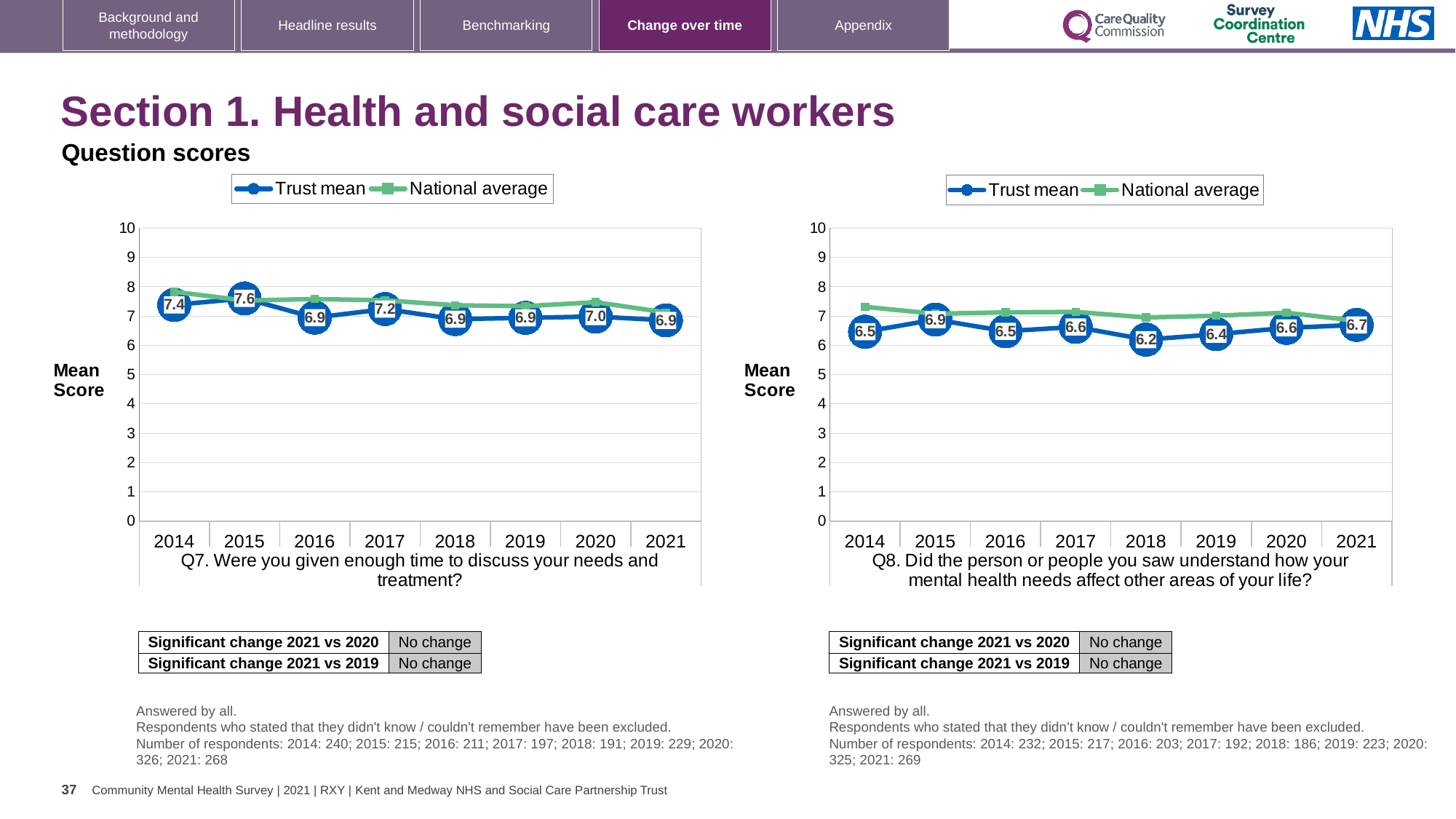
In the Q7 chart, which year has the highest Trust mean? 2015 In the Q7 chart, what is the Trust mean for 2021? 6.9 In the Q8 chart, what is the Trust mean for 2018? 6.2 In the Q7 chart, what is the Trust mean for 2015? 7.6 In the Q8 chart, which year has the lowest Trust mean? 2018 In the Q7 chart, what is the difference between the Trust mean in 2015 and in 2016? 0.7 How many years are plotted on the x axis of the Q8 chart? 8 How many series does the legend of the Q7 chart list? 2 In the Q8 chart, which year has the highest Trust mean? 2015 In the Q8 chart, what is the difference between the Trust mean in 2021 and in 2018? 0.5 In the Q8 chart, is the Trust mean larger in 2021 or in 2014? 2021 In the Q7 chart, is the National average for 2014 greater or less than 7? greater